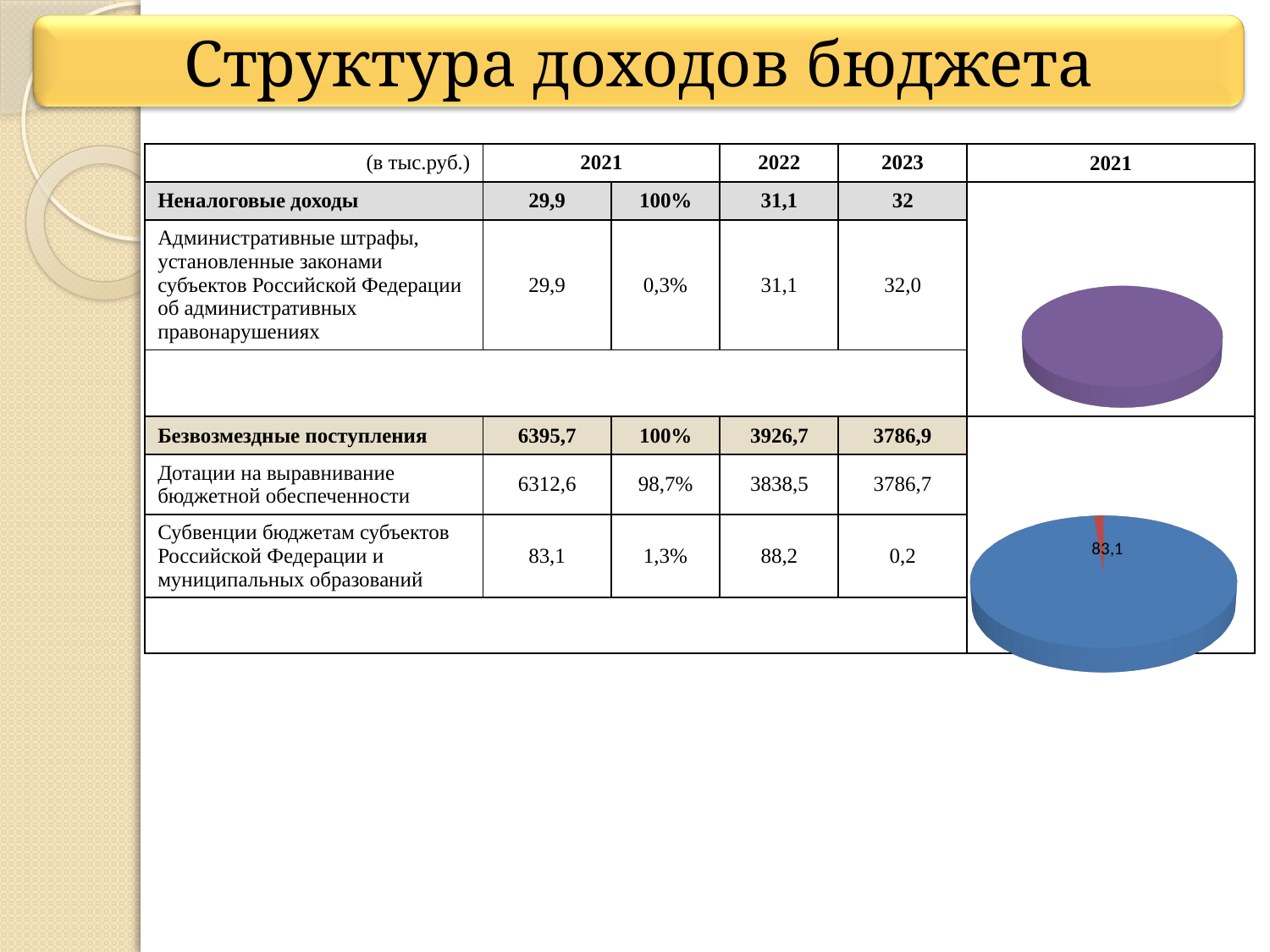
What colour is the upper pie chart? purple In the lower pie chart, what value is printed as the data label on the small red slice? 83,1 What kind of chart is shown at the upper right of the slide, next to the 'Неналоговые доходы' rows? pie chart In the lower pie chart, what colour is the slice that takes up almost the whole pie? blue In the lower pie chart, which slice is larger, the blue one or the red one? the blue one In the lower pie chart, how many slices are visible? 2 In the lower pie chart, which slice is the smallest? the red slice labelled 83,1 What kind of chart is shown at the lower right of the slide? pie chart Does the lower pie chart show a legend? no